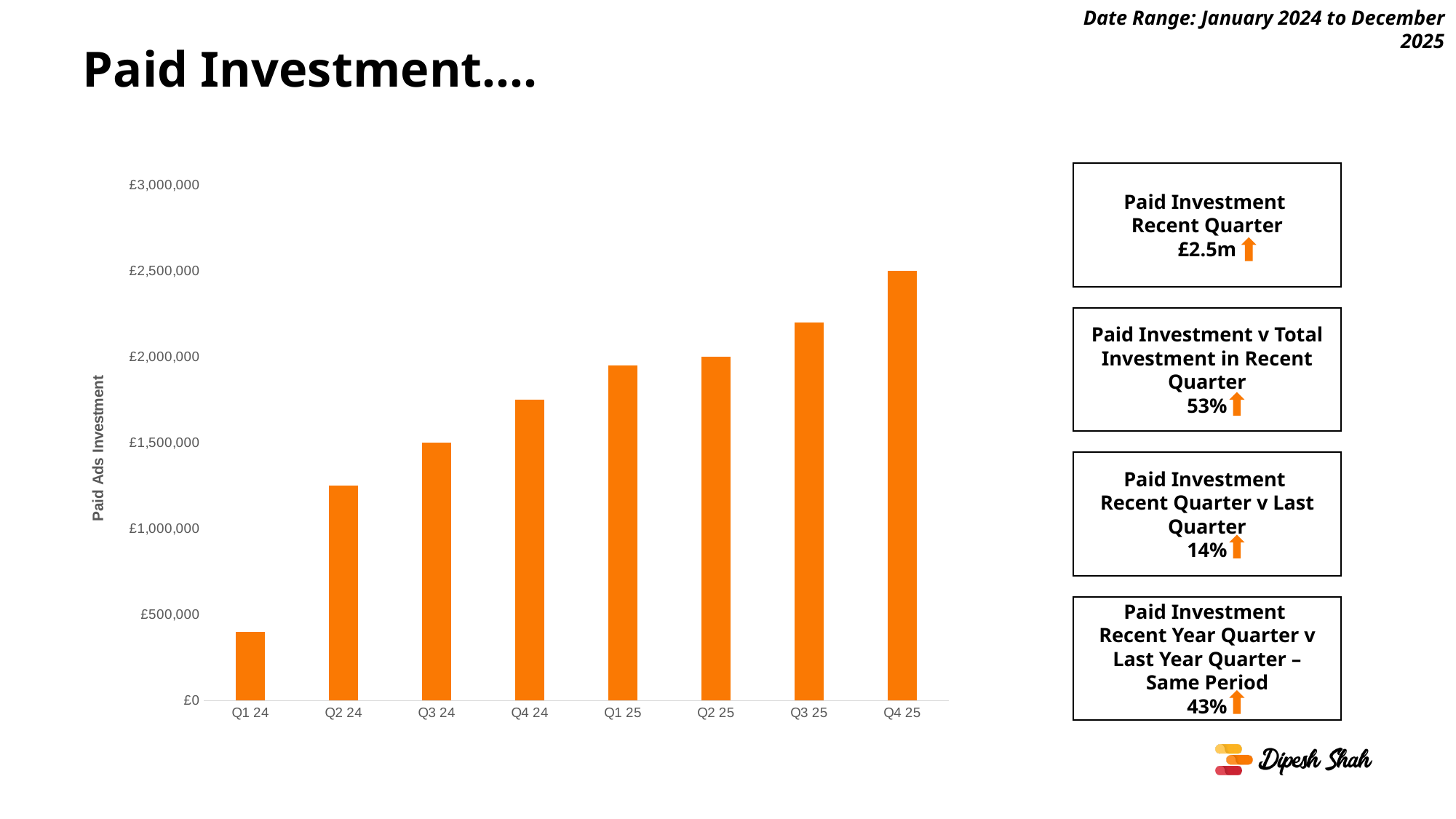
How many quarters are plotted on the chart? 8 Do the values rise or fall from Q1 24 to Q4 25? rise Which quarter has the lowest paid ads investment? Q1 24 Is the value for Q1 24 greater or less than £500,000? less Which is larger, the value for Q4 24 or the value for Q2 24? Q4 24 Is the value for Q2 24 greater or less than £1,000,000? greater What is the title of the vertical axis? Paid Ads Investment Is the value for Q3 25 greater or less than £2,000,000? greater What is the paid ads investment for Q4 25? £2,500,000 What kind of chart is shown on the slide? bar chart What is the paid ads investment for Q3 24? £1,500,000 Which quarter has the highest paid ads investment? Q4 25